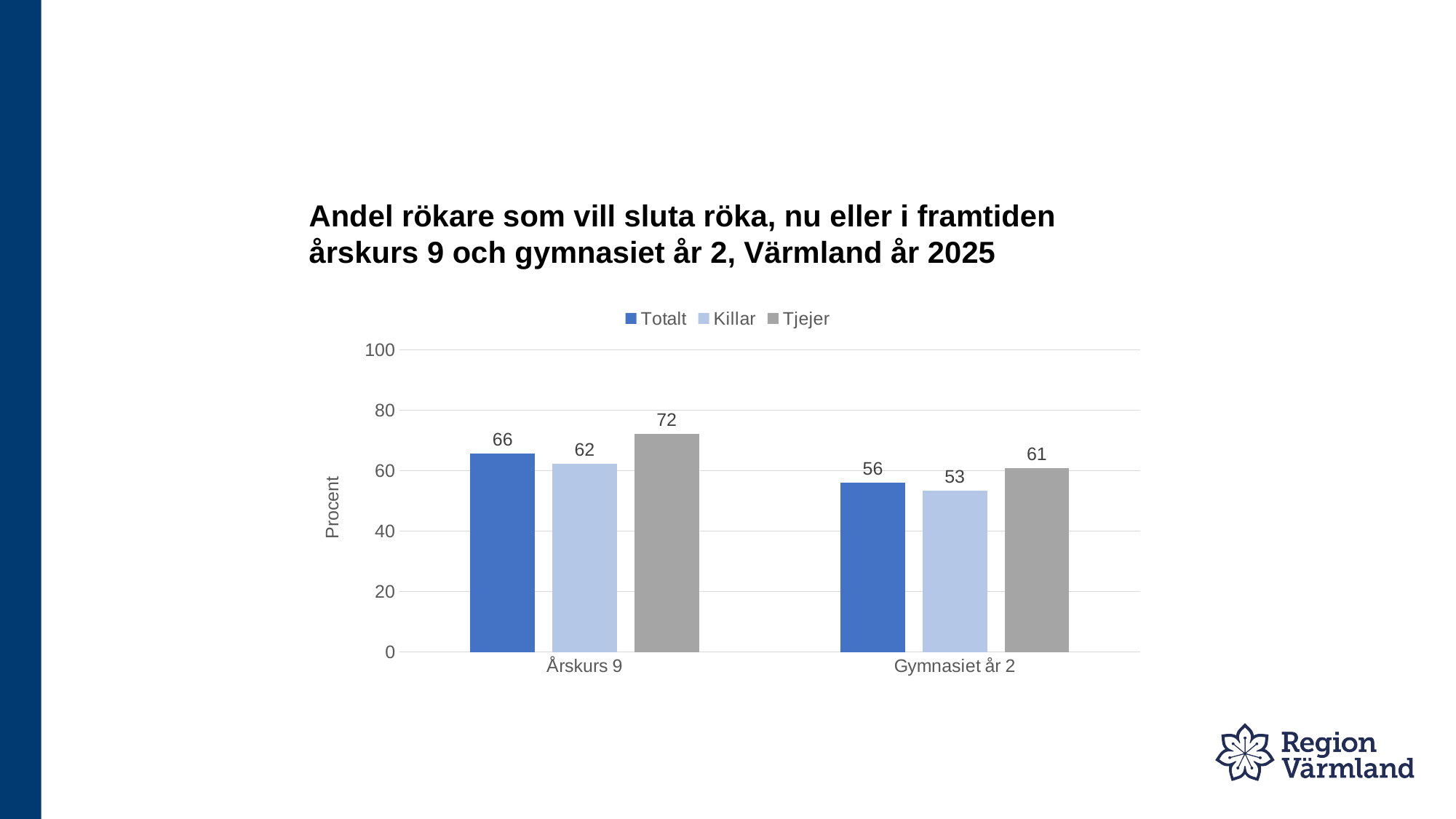
What is the value for Tjejer in Gymnasiet år 2? 61 Which is larger: Killar in Årskurs 9 or Tjejer in Gymnasiet år 2? Killar in Årskurs 9 How many series does the legend list? 3 How many categories are shown on the x axis? 2 What is the difference between Tjejer and Killar in Årskurs 9? 10 Is the value for Tjejer in Årskurs 9 greater or less than 80? less What is the value for Killar in Gymnasiet år 2? 53 What is the difference between the Totalt values for Årskurs 9 and Gymnasiet år 2? 10 What kind of chart is shown on the slide? bar chart Which series has the highest value in Årskurs 9? Tjejer What is the value for Totalt in Årskurs 9? 66 Which series has the lowest value in Gymnasiet år 2? Killar